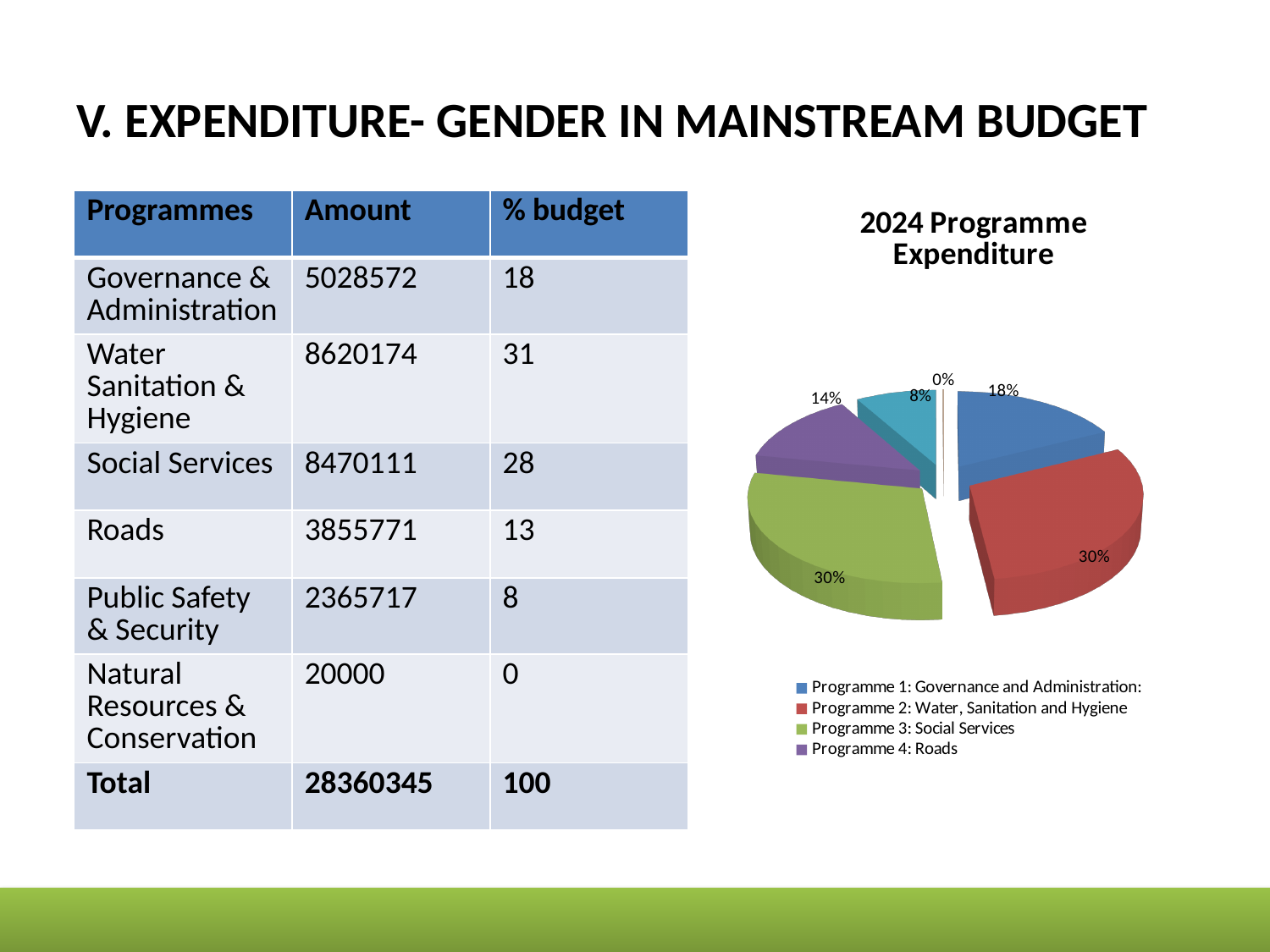
What kind of chart is shown on the slide? Pie chart What is the smallest percentage labelled on the pie chart? 0% What share of the pie does Programme 2: Water, Sanitation and Hygiene have? 30% What is the difference in percentage points between Programme 2: Water, Sanitation and Hygiene and Programme 4: Roads? 16 What share of the pie does Programme 1: Governance and Administration have? 18% How many percentage labels are shown on the pie chart? 6 What share of the pie does Programme 3: Social Services have? 30% What is the title of the pie chart? 2024 Programme Expenditure How many entries does the legend of the pie chart list? 4 Which colour represents Programme 3: Social Services in the pie chart? Green Which is larger in the pie chart: Programme 1: Governance and Administration or Programme 4: Roads? Programme 1: Governance and Administration